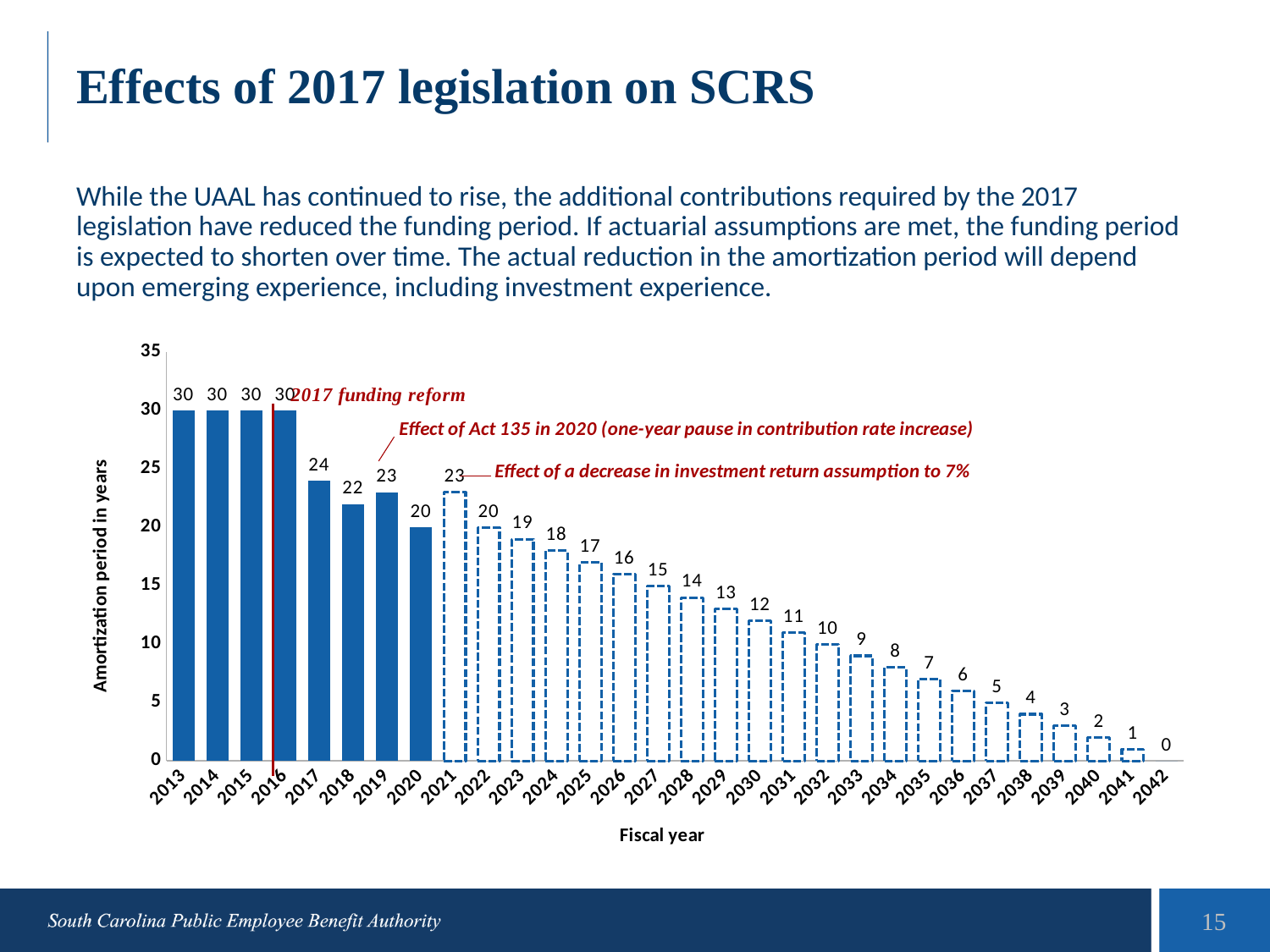
What is the amortization period in years for fiscal year 2021? 23 What is the amortization period in years for fiscal year 2030? 12 What kind of chart is shown on the slide? Bar chart How many fiscal years are shown on the x axis of the chart? 30 What is the difference in amortization period between fiscal year 2016 and fiscal year 2017? 6 Do the amortization period values generally rise or fall from fiscal year 2021 to 2042? Fall Which has a larger amortization period, fiscal year 2018 or fiscal year 2019? 2019 Which fiscal year has the lowest amortization period? 2042 What is the difference in amortization period between fiscal year 2020 and fiscal year 2021? 3 What is the amortization period in years for fiscal year 2042? 0 What is the amortization period in years for fiscal year 2017? 24 What is the label of the y axis of the chart? Amortization period in years